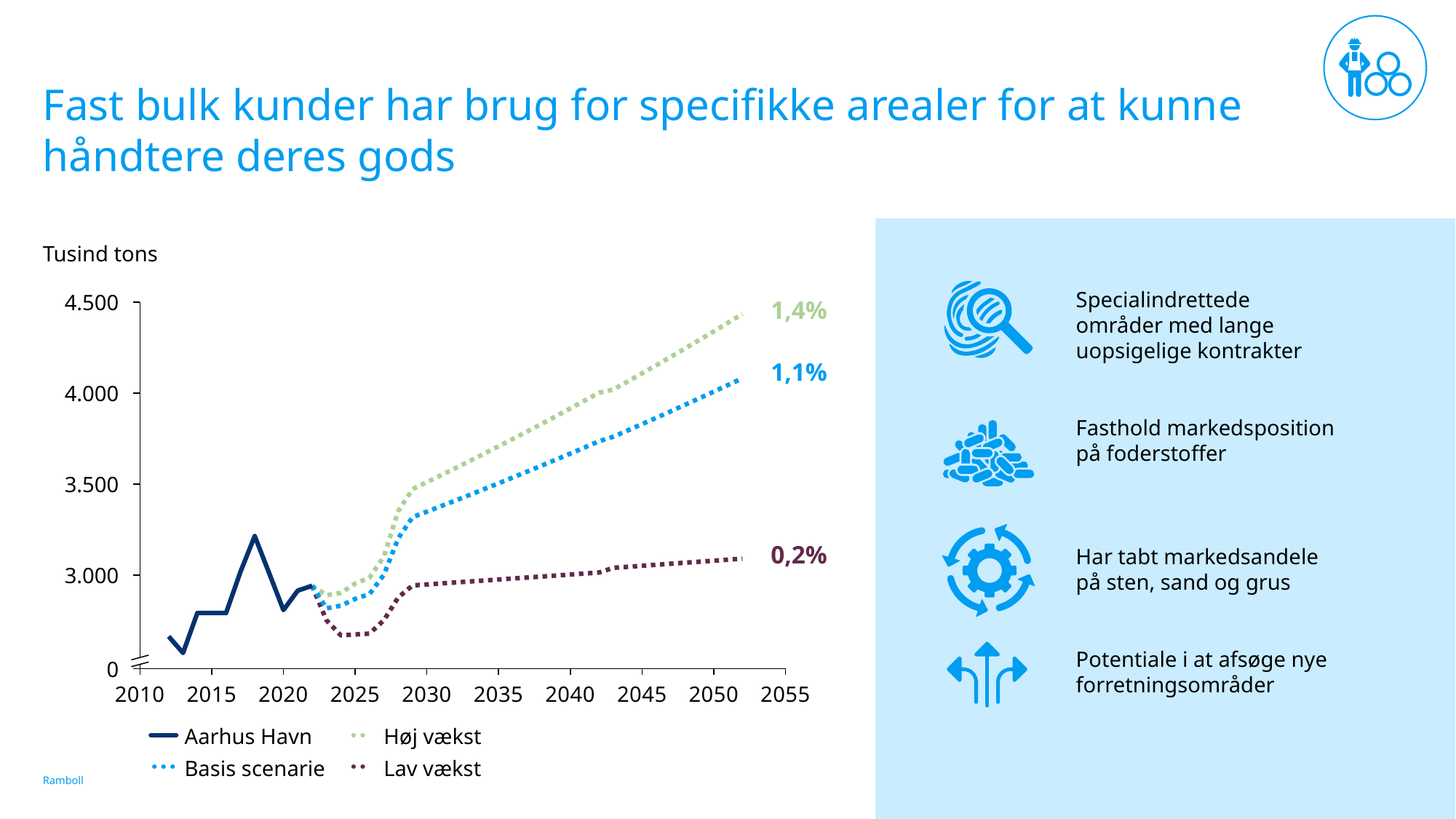
Which is larger in 2045, the Basis scenarie value or the Lav vækst value? Basis scenarie Does the Høj vækst line rise or fall between 2030 and 2050? rise Is the value for Høj vækst in 2050 greater or less than 4.000? greater What kind of chart is shown on the slide? line chart How many series does the chart legend list? 4 Which scenario line ends highest at the right end of the chart? Høj vækst What growth rate is printed at the end of the Basis scenarie line? 1,1% Which scenario line ends lowest at the right end of the chart? Lav vækst What growth rate is printed at the end of the Lav vækst line? 0,2% What growth rate is printed at the end of the Høj vækst line? 1,4% What unit is given for the y axis of the chart? Tusind tons Is the value for Lav vækst in 2050 greater or less than 3.500? less